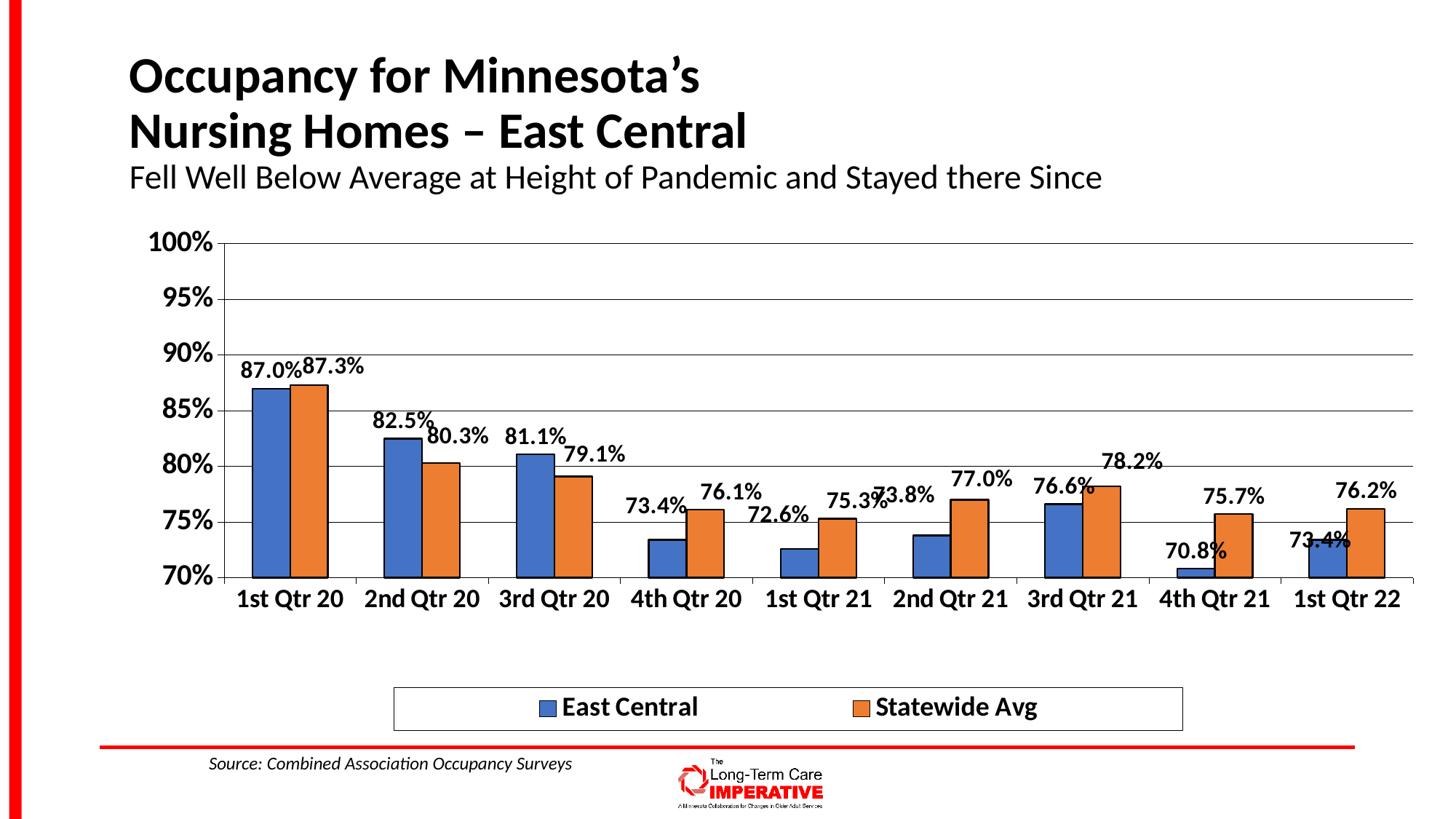
What is the difference between the East Central values in 1st Qtr 20 and 2nd Qtr 20? 4.5% What kind of chart is shown on the slide? Bar chart In 2nd Qtr 20, which is larger: East Central or Statewide Avg? East Central What is the Statewide Avg occupancy value for 2nd Qtr 21? 77.0% How many quarters are shown on the x axis? 9 What is the East Central occupancy value for 3rd Qtr 20? 81.1% How many series does the legend list? 2 In which quarter is the East Central occupancy lowest? 4th Qtr 21 What is the difference between the Statewide Avg and East Central values in 4th Qtr 21? 4.9% What is the East Central occupancy value for 4th Qtr 21? 70.8% In 1st Qtr 22, which is larger: East Central or Statewide Avg? Statewide Avg In which quarter is the Statewide Avg occupancy highest? 1st Qtr 20